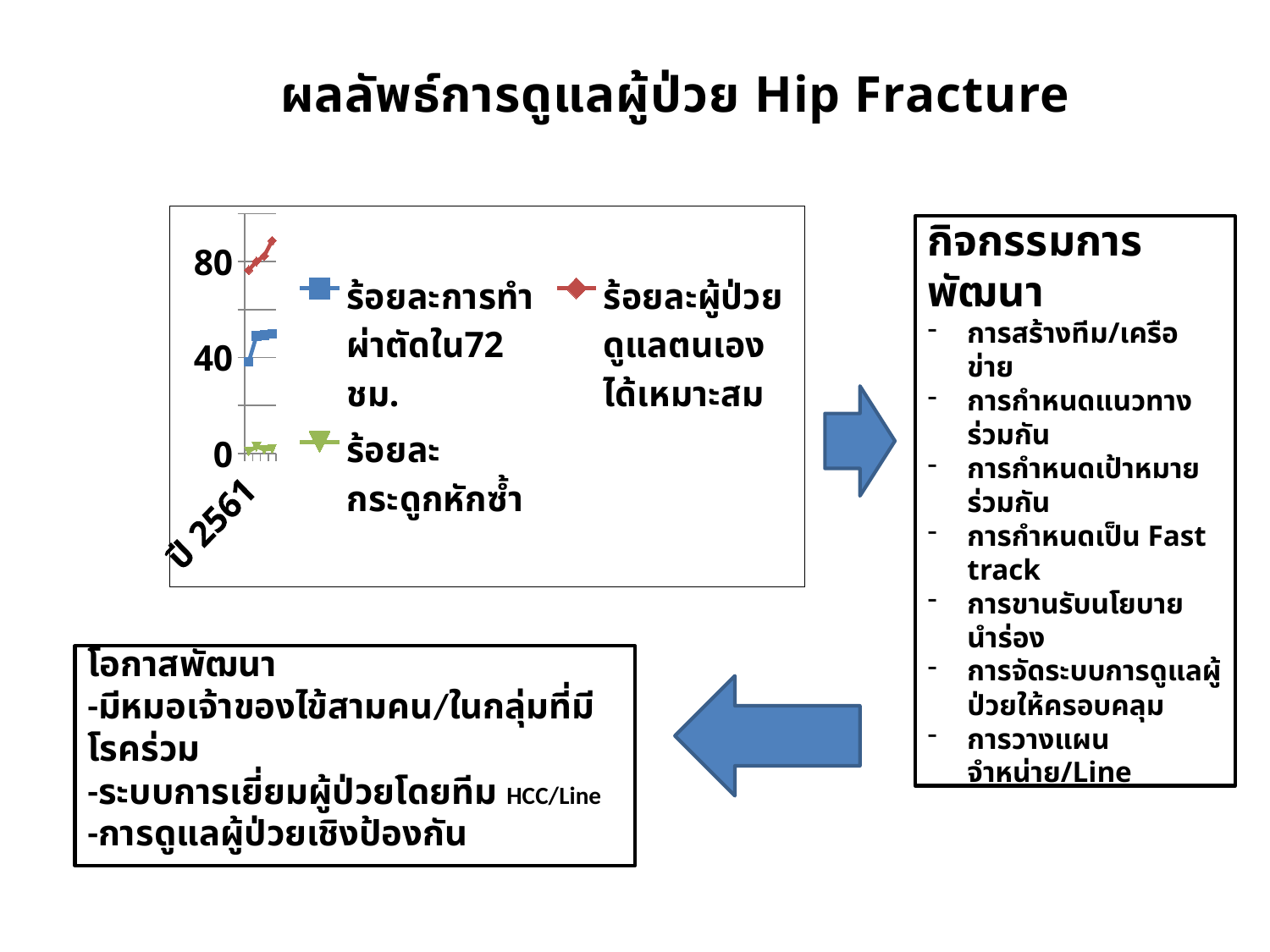
Which series has the lowest values in the chart? ร้อยละกระดูกหักซ้ำ Are the values for ร้อยละการทำผ่าตัดใน72 ชม. greater or less than 80? less Which series is plotted with the red line in the chart? ร้อยละผู้ป่วยดูแลตนเองได้เหมาะสม How many series does the chart legend list? 3 Which series has higher values, ร้อยละการทำผ่าตัดใน72 ชม. or ร้อยละกระดูกหักซ้ำ? ร้อยละการทำผ่าตัดใน72 ชม. Are the values for ร้อยละกระดูกหักซ้ำ greater or less than 40? less Which series has higher values, ร้อยละผู้ป่วยดูแลตนเองได้เหมาะสม or ร้อยละกระดูกหักซ้ำ? ร้อยละผู้ป่วยดูแลตนเองได้เหมาะสม Are the values for ร้อยละผู้ป่วยดูแลตนเองได้เหมาะสม greater or less than 40? greater Which series has the highest values in the chart? ร้อยละผู้ป่วยดูแลตนเองได้เหมาะสม What kind of chart is shown on the slide? line chart Do the values for ร้อยละผู้ป่วยดูแลตนเองได้เหมาะสม rise or fall along the x axis? rise Which series is plotted with the green line in the chart? ร้อยละกระดูกหักซ้ำ